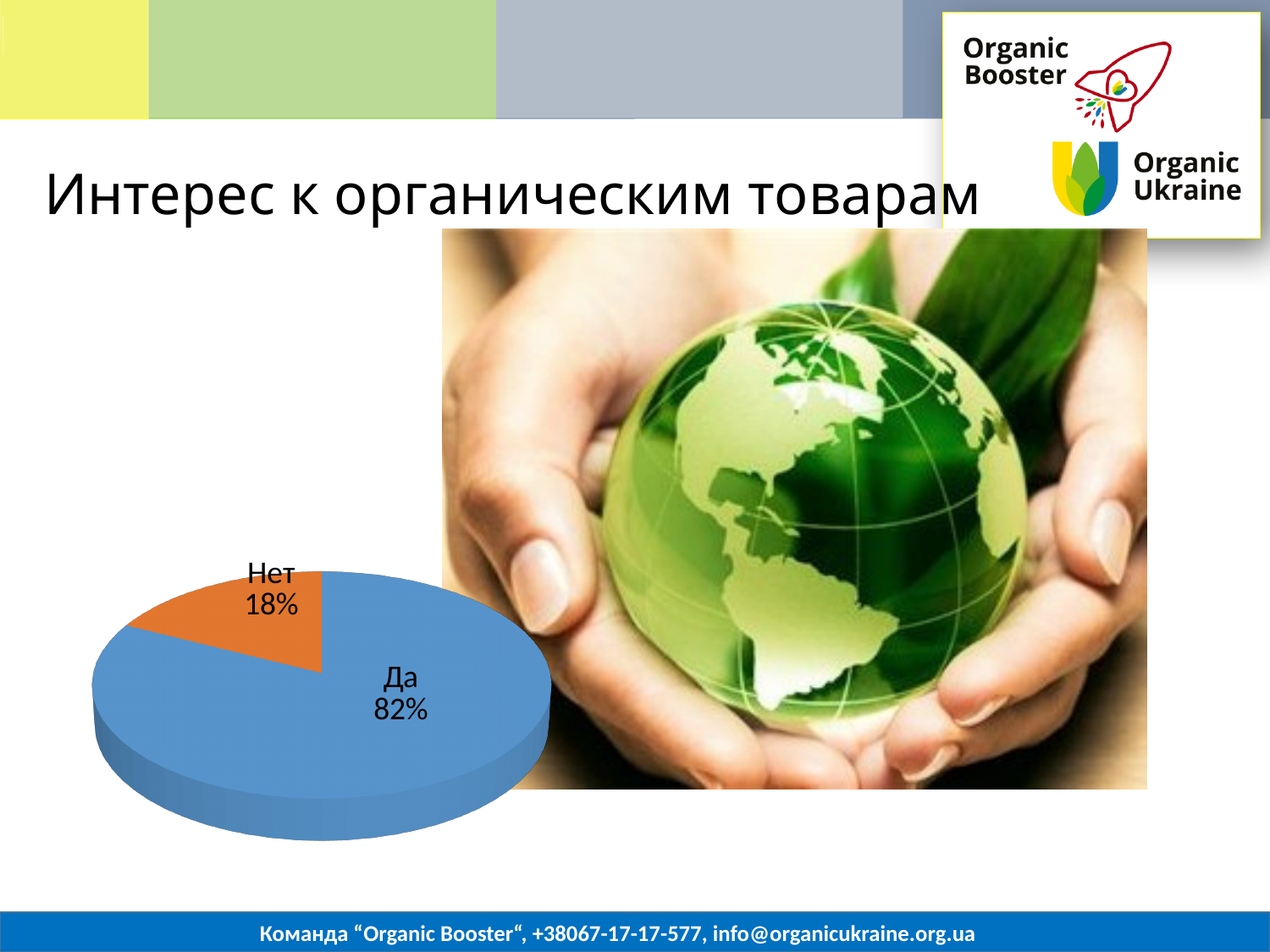
How many slices does the pie chart have? 2 What share of the pie chart is labelled "Да"? 82% Which is larger, the "Да" slice or the "Нет" slice? Да Which slice of the pie chart is the largest? Да What colour is the "Нет" slice of the pie chart? Orange What kind of chart is shown on the slide? Pie chart Which slice of the pie chart is the smallest? Нет What is the difference in percentage points between the "Да" and "Нет" slices? 64 What colour is the "Да" slice of the pie chart? Blue What share of the pie chart is labelled "Нет"? 18%